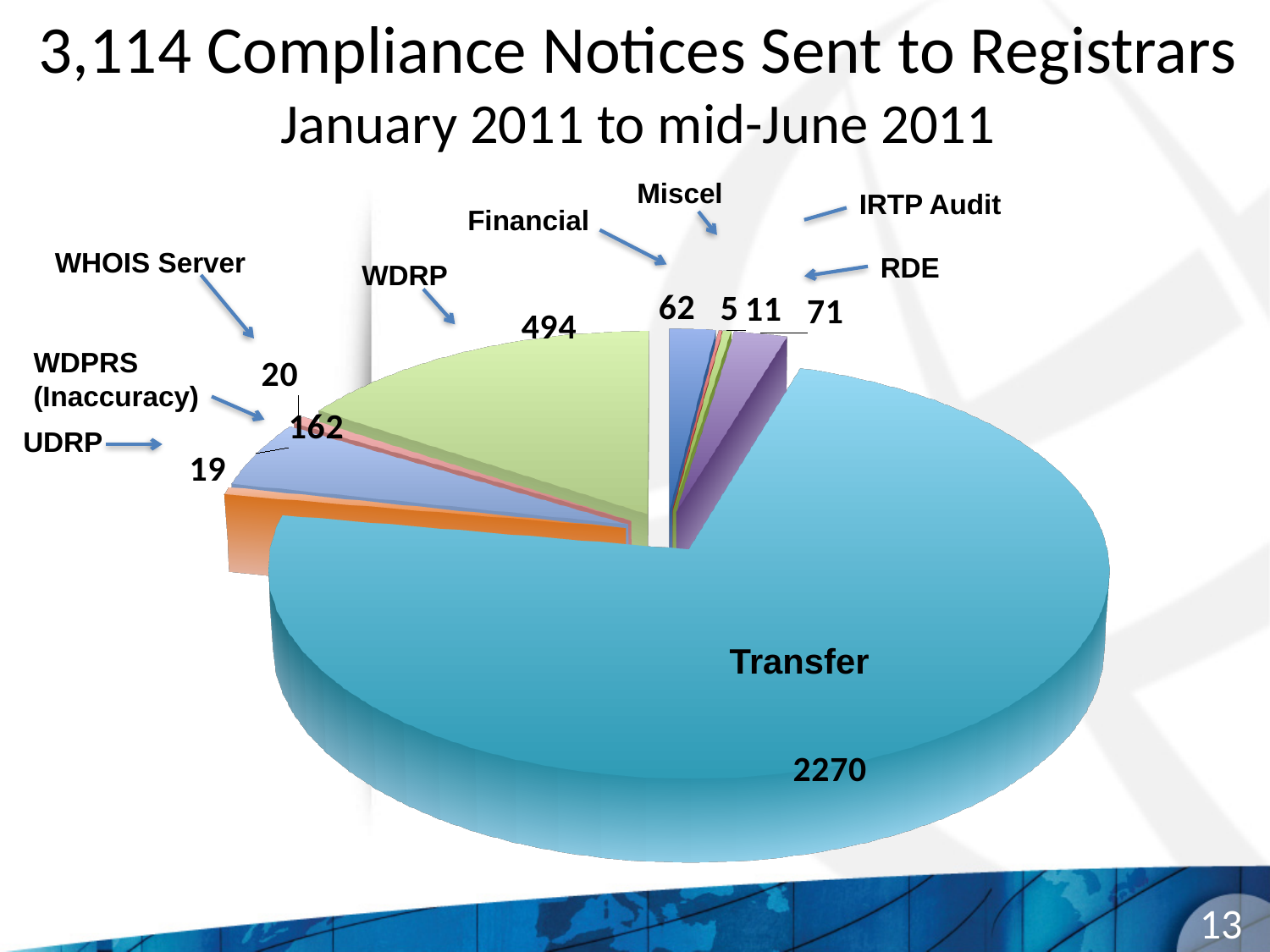
What is the difference between the Transfer and WDRP values? 1776 What is the value for Miscel? 5 Which category has the smallest value? Miscel How many compliance notices were sent for Transfer? 2270 What type of chart is shown on the slide? Pie chart What is the value for WDRP? 494 What is the value for RDE? 71 Which category has the largest slice of the pie? Transfer What is the value for WDPRS (Inaccuracy)? 162 Which is larger, the value for Financial or the value for RDE? RDE What is the total number of compliance notices stated in the chart title? 3,114 How many categories are shown in the pie chart? 9